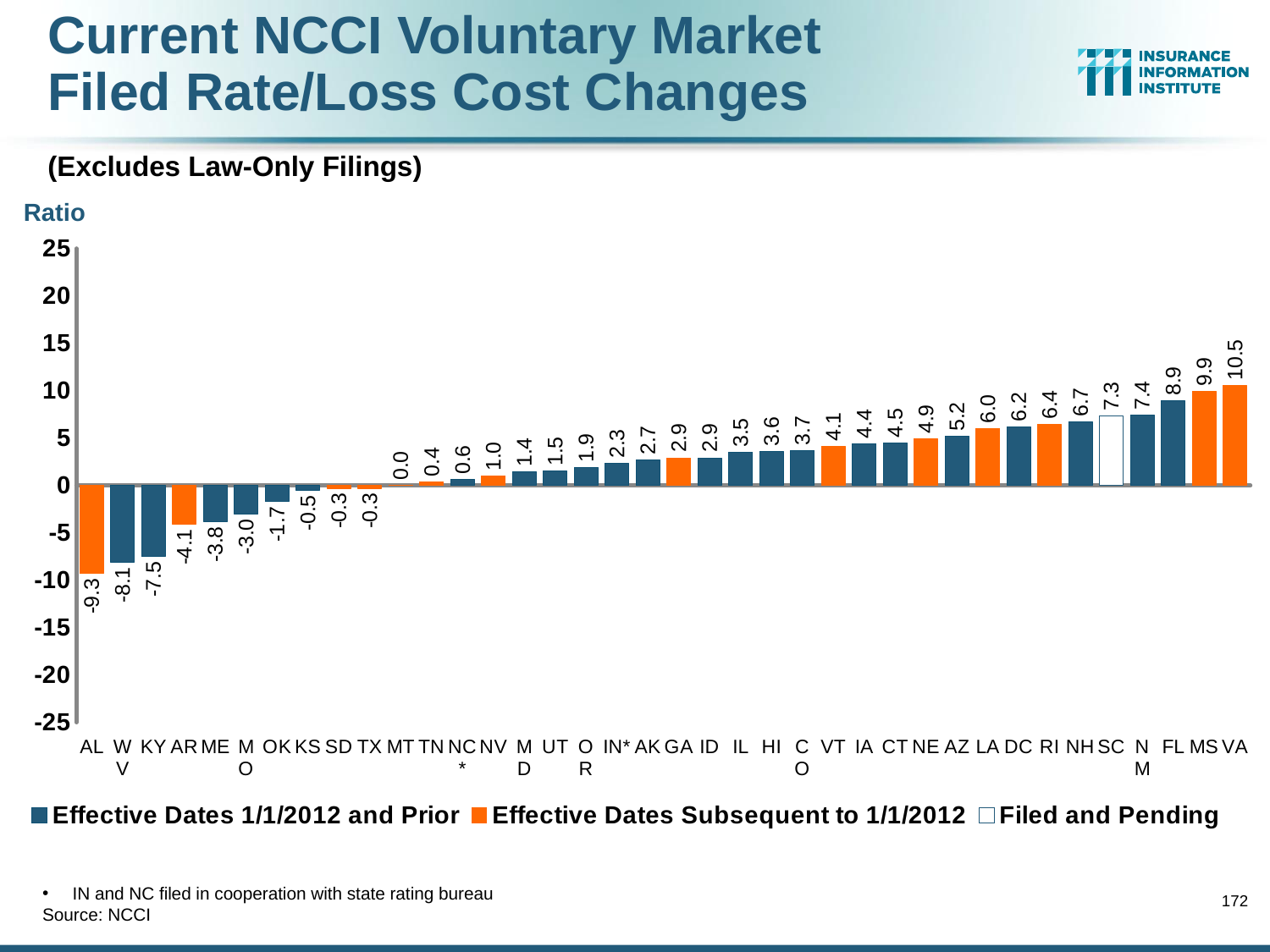
What is the difference between the values for VA and MS? 0.6 Which state has the lowest value? AL Do the values rise or fall moving from left to right along the x axis? Rise What kind of chart is this? Bar chart What is the value for SC? 7.3 Which state has the highest value? VA Which legend entry is shown with a white (unfilled) bar? Filed and Pending What is the value for VA? 10.5 How many states or jurisdictions are shown on the x axis? 38 What is the value for AL? -9.3 Which has a larger value, FL or NH? FL How many series does the legend list? 3